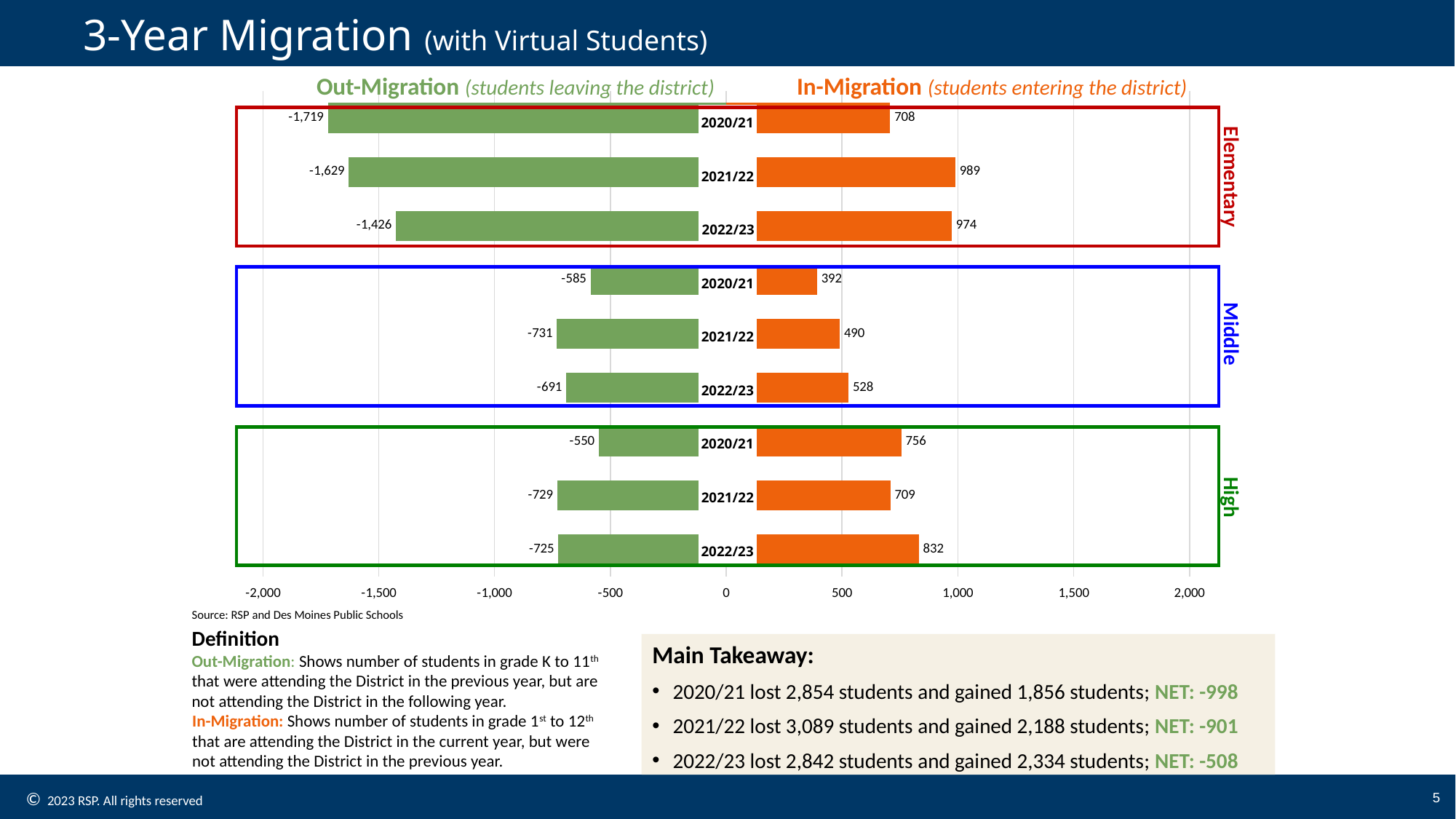
What is the difference between the Elementary In-Migration values for 2021/22 and 2022/23? 15 How many school levels (grade groups) are shown in the chart? 3 What colour are the In-Migration bars? Orange Which year has the lowest In-Migration value for Middle? 2020/21 What is the In-Migration value for High in 2020/21? 756 For High, which year has the larger In-Migration value, 2021/22 or 2022/23? 2022/23 Which year has the highest In-Migration value for Elementary? 2021/22 Does the length of the Elementary Out-Migration bar get larger or smaller from 2020/21 to 2022/23? Smaller What is the In-Migration value for Middle in 2022/23? 528 What is the Out-Migration value for Elementary in 2020/21? -1,719 What is the difference between the Middle Out-Migration values for 2021/22 and 2022/23? 40 What kind of chart is shown on the slide? Bar chart